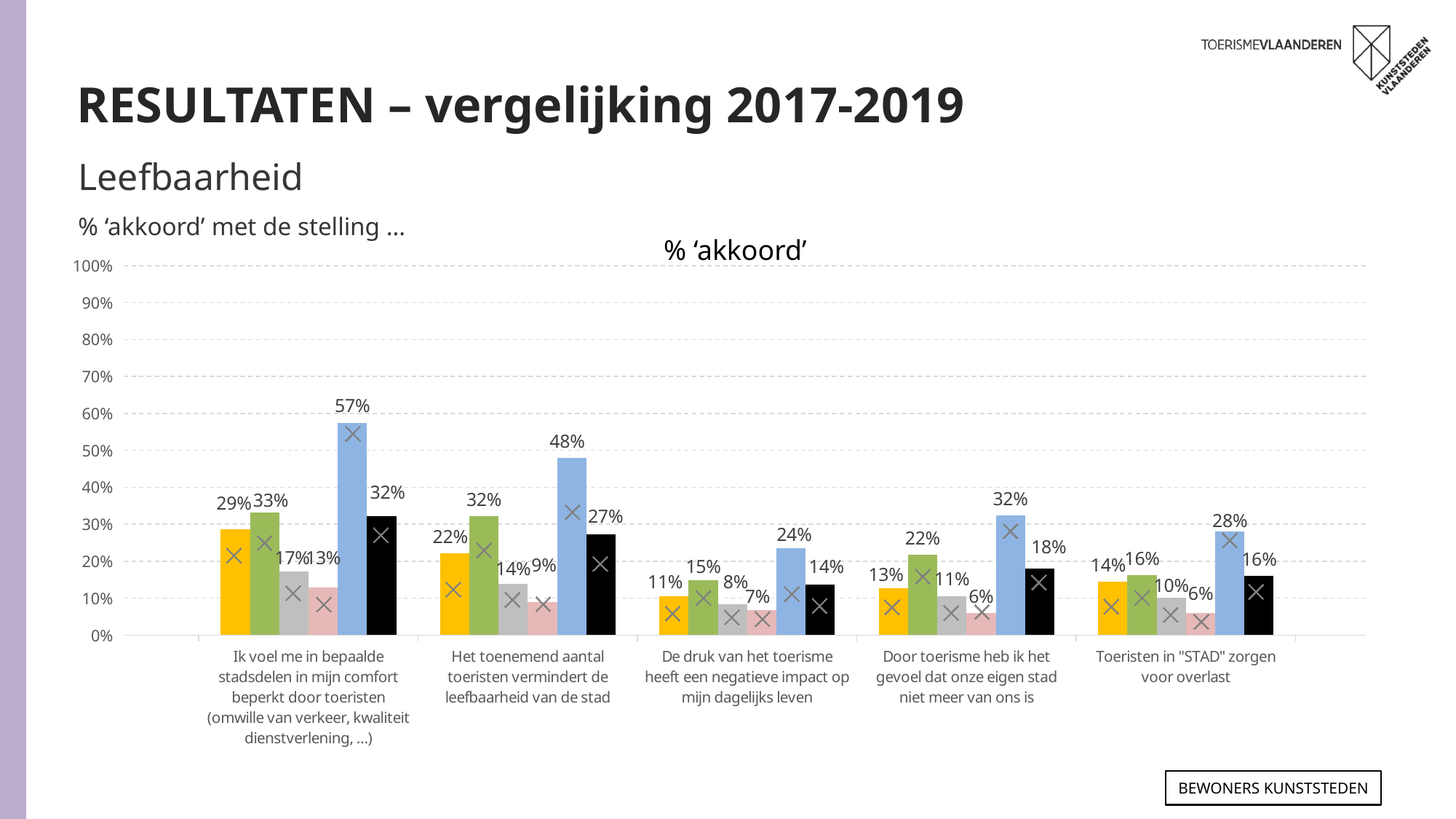
Which statement has the lowest blue bar value? De druk van het toerisme heeft een negatieve impact op mijn dagelijks leven What is the value of the orange bar for the statement 'Door toerisme heb ik het gevoel dat onze eigen stad niet meer van ons is'? 13% What is the title shown above the chart's plot area? % ‘akkoord’ What is the difference between the blue bar (57%) and the black bar (32%) for the statement 'Ik voel me in bepaalde stadsdelen in mijn comfort beperkt door toeristen'? 25% What is the value of the black bar for the statement 'De druk van het toerisme heeft een negatieve impact op mijn dagelijks leven'? 14% How many statement categories are shown along the x axis of the chart? 5 Which statement has the highest blue bar value? Ik voel me in bepaalde stadsdelen in mijn comfort beperkt door toeristen (omwille van verkeer, kwaliteit dienstverlening, ...) What is the value of the blue bar for the statement 'Toeristen in "STAD" zorgen voor overlast'? 28% For the statement 'Door toerisme heb ik het gevoel dat onze eigen stad niet meer van ons is', which is larger: the green bar or the black bar? the green bar What is the value of the green bar for the statement 'Het toenemend aantal toeristen vermindert de leefbaarheid van de stad'? 32% Is the blue bar for the statement 'Het toenemend aantal toeristen vermindert de leefbaarheid van de stad' greater or less than 40%? greater What type of chart is shown on the slide? bar chart